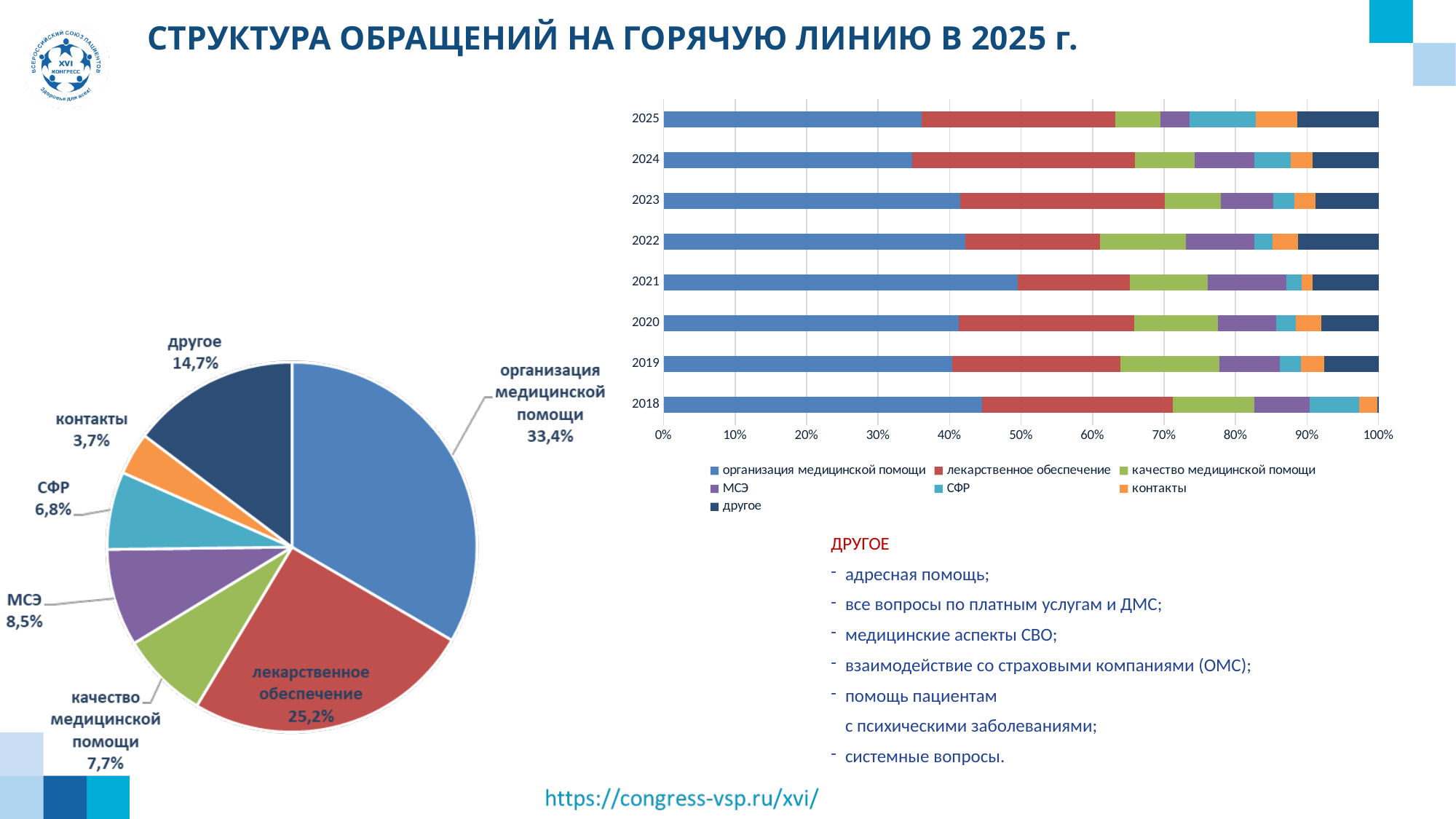
In the pie chart on the left, which category has the largest share? организация медицинской помощи In the pie chart on the left, what share of appeals is for организация медицинской помощи? 33,4% How many series does the legend of the bar chart on the right list? 7 What kind of chart is shown on the right side of the slide? Stacked bar chart In the pie chart on the left, which is larger: the share for СФР or the share for качество медицинской помощи? качество медицинской помощи How many years are shown on the vertical axis of the bar chart on the right? 8 In the pie chart on the left, what is the difference in percentage points between организация медицинской помощи and лекарственное обеспечение? 8,2 In the pie chart on the left, which category has the smallest share? контакты In the pie chart on the left, what share of appeals is for лекарственное обеспечение? 25,2% In the pie chart on the left, what share of appeals is for МСЭ? 8,5% In the bar chart on the right, is the share of организация медицинской помощи in 2025 greater or less than 40%? less How many slices does the pie chart on the left have? 7